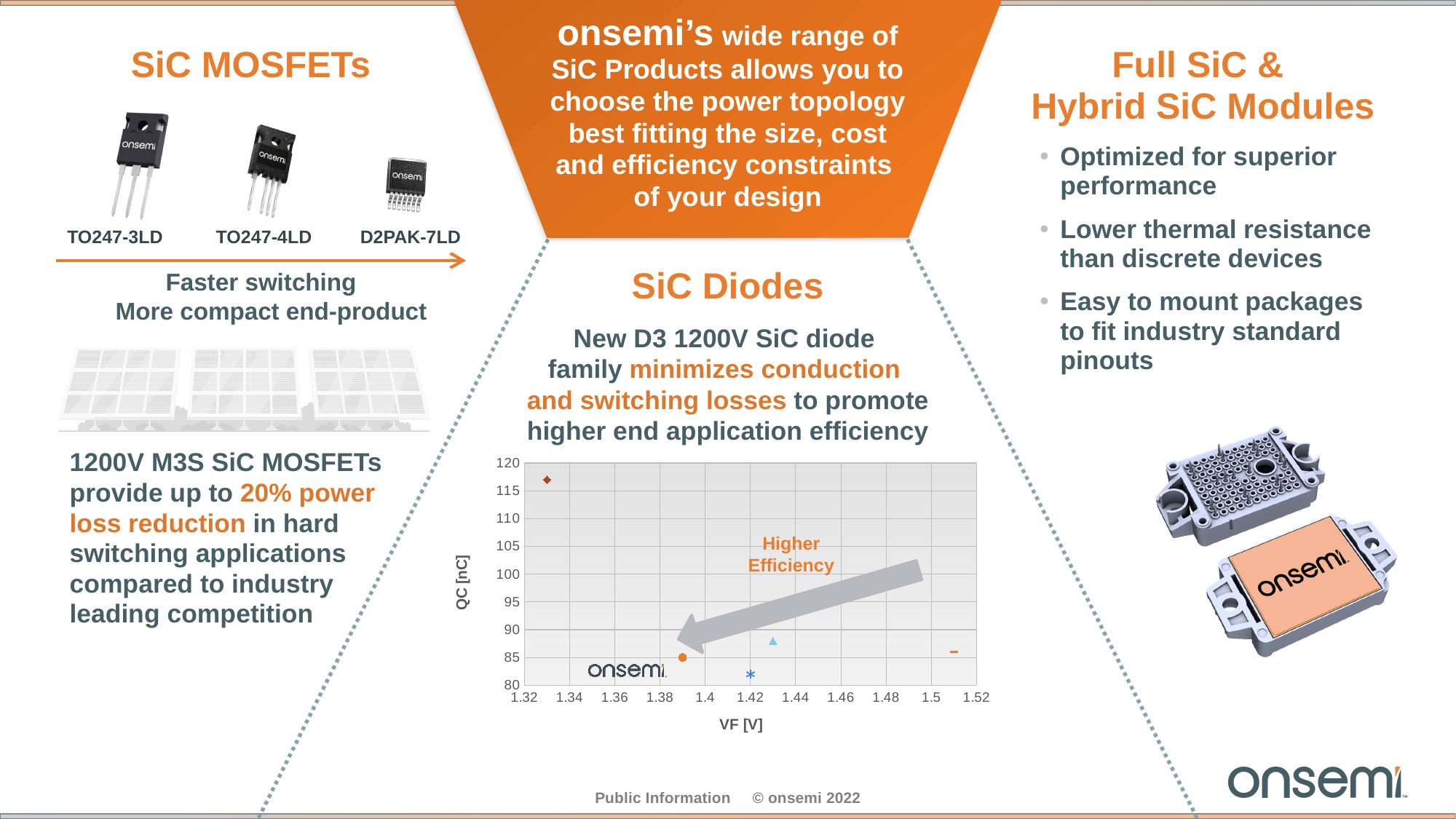
What is the label of the horizontal axis of the scatter chart? VF [V] What is the label of the vertical axis of the scatter chart? QC [nC] What kind of chart is shown on the slide under the SiC Diodes heading? scatter chart On the scatter chart, is the VF value of the orange dash marker greater or less than 1.5? greater On the scatter chart, is the QC value of the blue asterisk marker greater or less than 85? less Which marker on the scatter chart has the highest QC value? the red diamond On the scatter chart, which has the higher QC value: the red diamond marker or the blue triangle marker? the red diamond Which marker on the scatter chart has the lowest QC value? the blue asterisk How many data points are plotted on the scatter chart? 5 On the scatter chart, is the VF value of the red diamond marker greater or less than 1.34? less